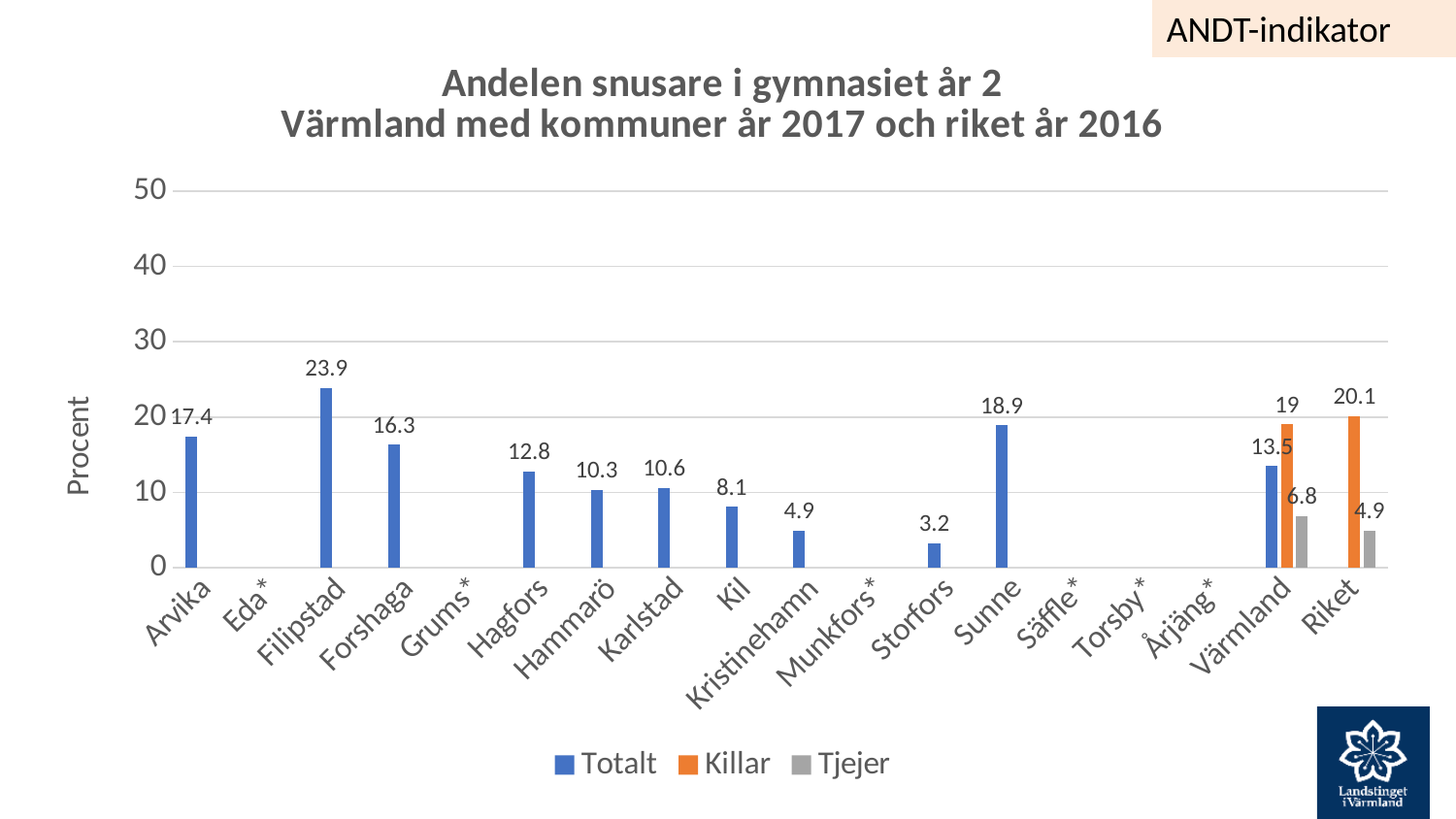
How many categories are shown on the x axis? 18 What is the Killar value for Riket? 20.1 How many series does the legend list? 3 Is the Totalt value for Kil greater or less than 10? less What kind of chart is shown on the slide? bar chart Which is larger, the Totalt value for Sunne or for Arvika? Sunne What is the Tjejer value for Värmland? 6.8 Which municipality has the highest Totalt value? Filipstad What is the Totalt value for Filipstad? 23.9 Among the municipalities with a plotted Totalt bar, which has the lowest value? Storfors What is the label of the y axis? Procent What is the difference between the Killar and Tjejer values for Värmland? 12.2